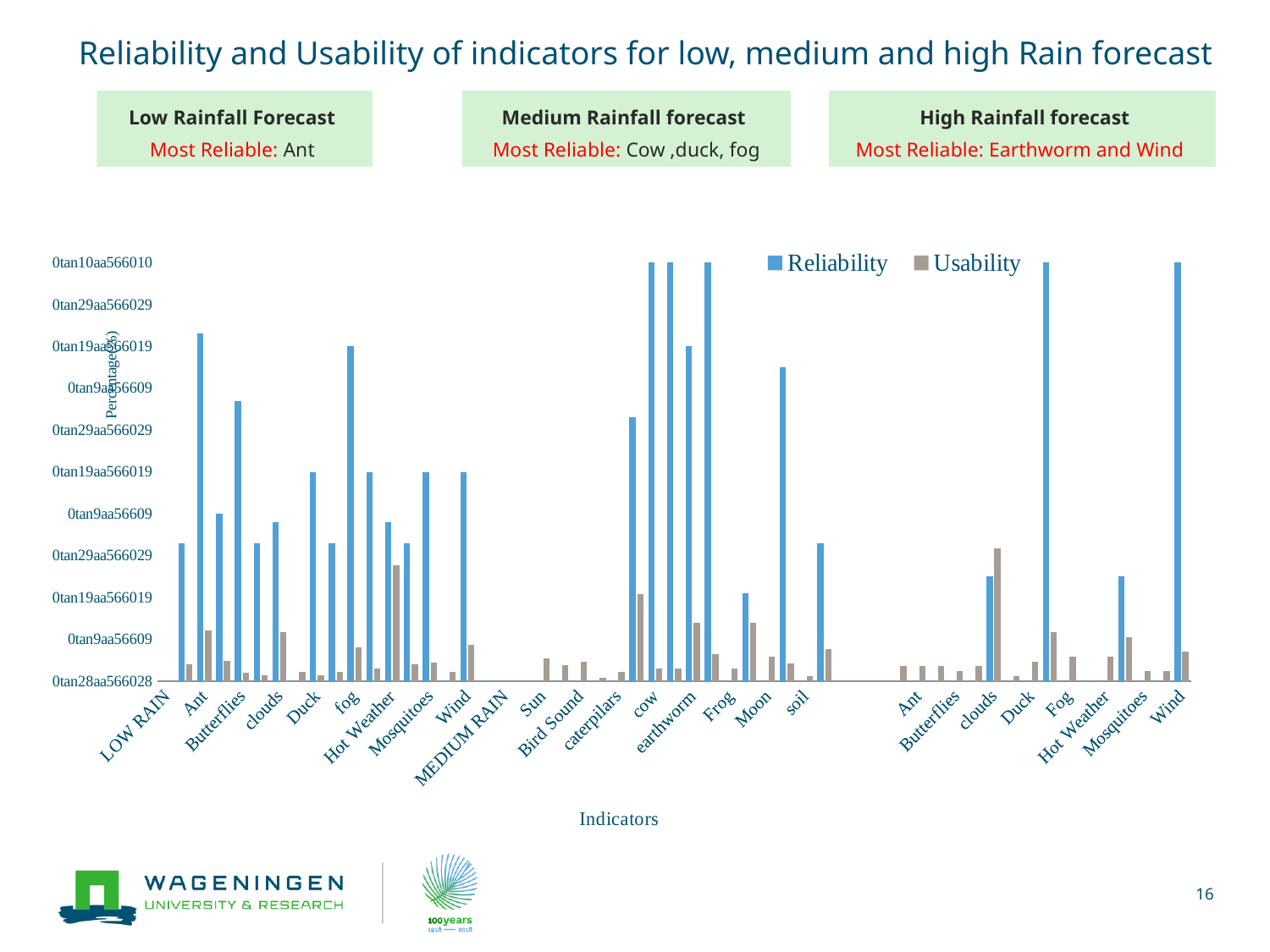
In the low rainfall group, which has the higher Usability bar, Hot Weather or Ant? Hot Weather What kind of chart is shown on the slide? Bar chart What is the title of the chart's x axis? Indicators In the medium rainfall group, which has the higher Reliability bar, cow or Frog? cow Among the low rainfall indicators, which has the highest Reliability bar? Ant Among the low rainfall indicators, which has the highest Usability bar? Hot Weather In the high rainfall group, which has the higher Reliability bar, Wind or Mosquitoes? Wind How many series does the chart legend list? 2 What are the two series named in the chart legend? Reliability and Usability